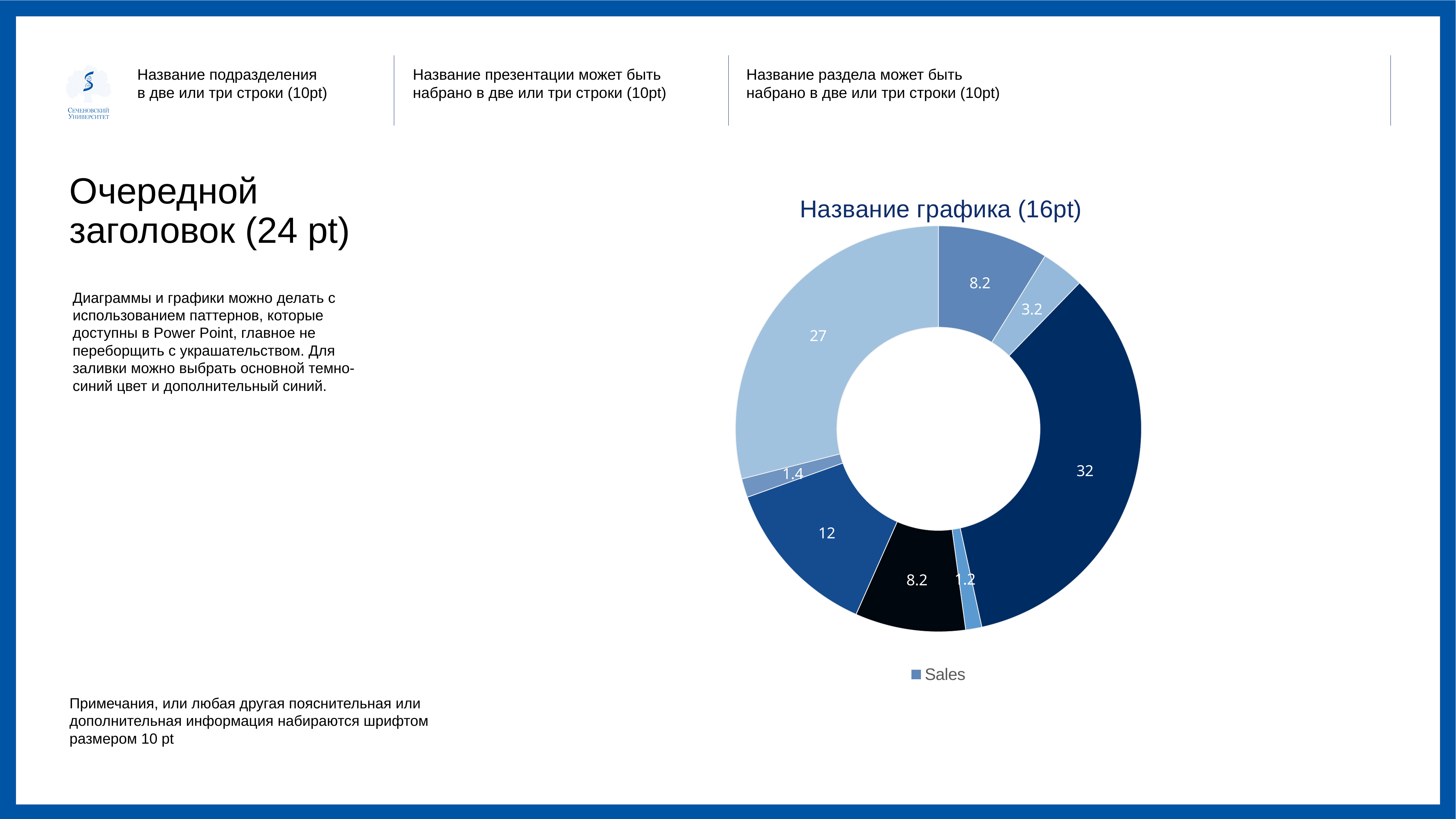
What is the value of the smallest slice in the doughnut chart? 1.2 How many series does the chart legend list? 1 How many slices does the doughnut chart have? 8 What is the difference between the slices labelled 3.2 and 1.4? 1.8 What is the name of the series shown in the chart legend? Sales Which is larger: the slice labelled 12 or the slice labelled 8.2? 12 How many slices in the doughnut chart are labelled 8.2? 2 What is the value of the largest slice in the doughnut chart? 32 What is the difference between the largest slice (32) and the slice labelled 27? 5 What kind of chart is shown on the slide? doughnut chart What is the total of all the slice values shown in the doughnut chart? 93.2 What is the title of the chart? Название графика (16pt)